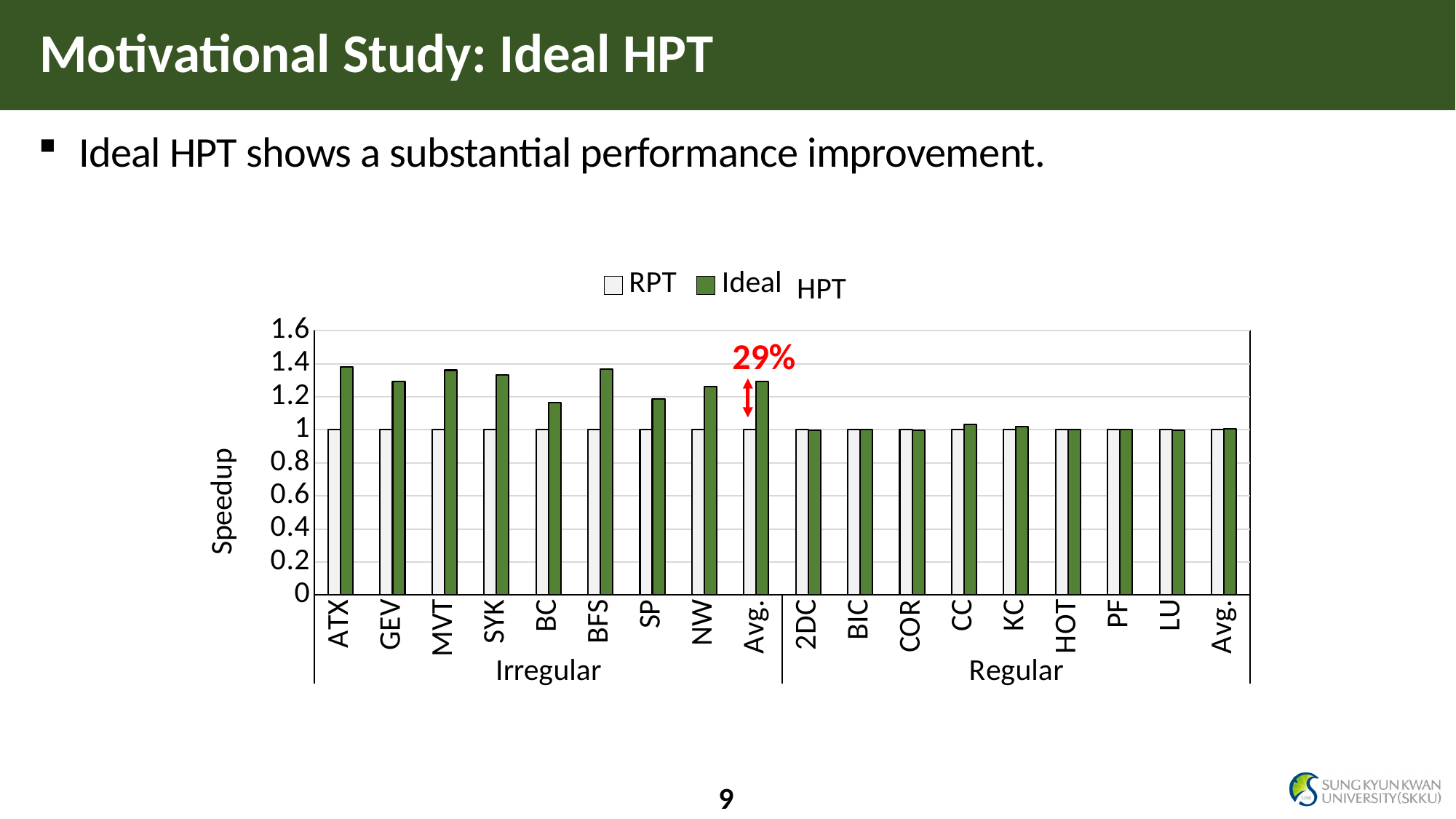
What kind of chart is shown on the slide? bar chart What is the RPT speedup value for ATX? 1 How many categories are plotted along the x axis? 18 Is the Ideal HPT value for ATX greater or less than 1.2? greater Is the Ideal HPT value for NW greater or less than 1.2? greater How many series does the legend list? 2 Which is larger, the Ideal HPT value for GEV or for SP? GEV Which is larger, the Ideal HPT value for ATX or for BC? ATX What is the label of the y axis? Speedup Is the Ideal HPT value for BC greater or less than 1.2? less What percentage improvement is annotated above the Irregular Avg. bars? 29%